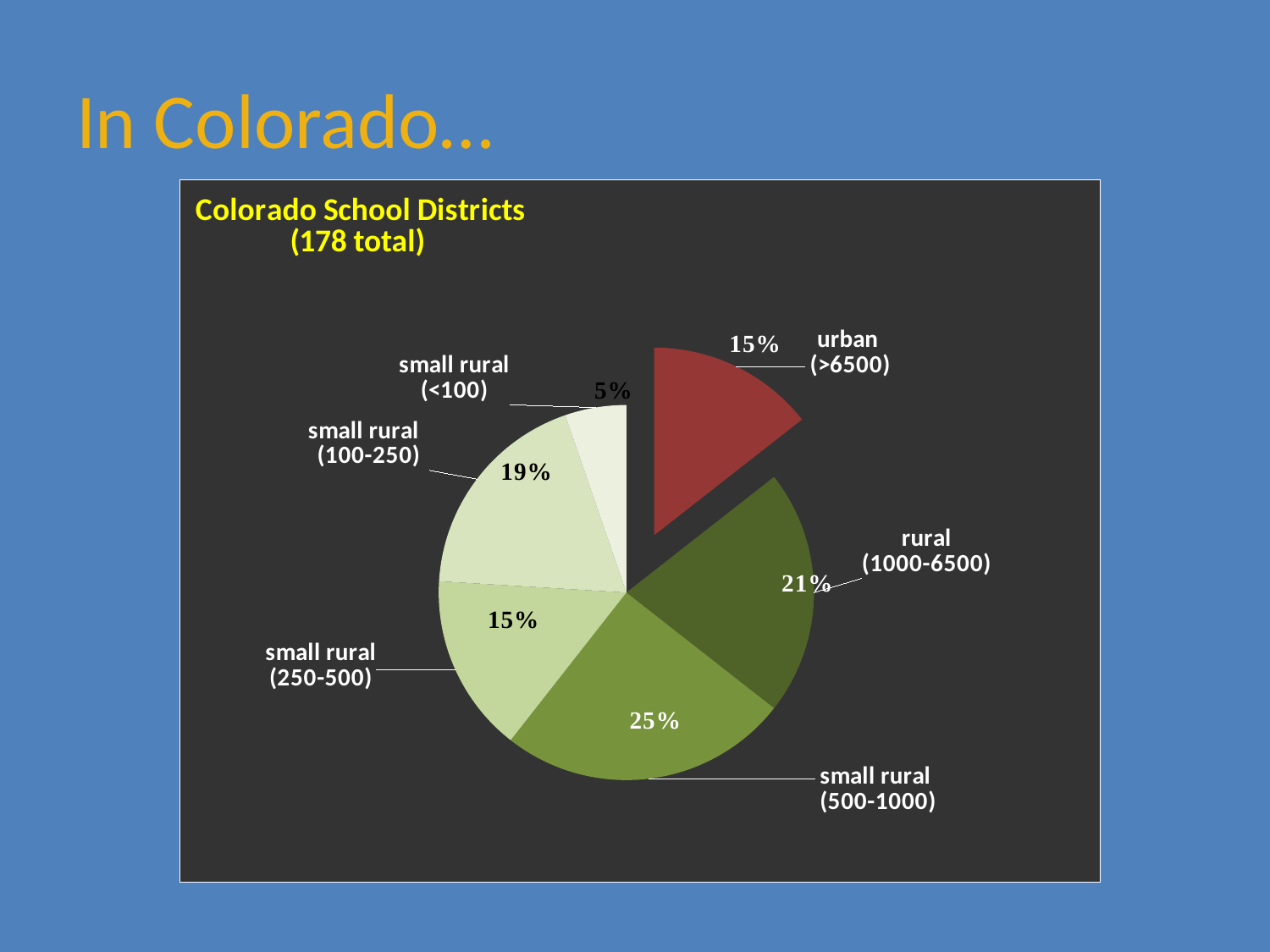
What share of the pie is the small rural (500-1000) slice? 25% Which is larger, the rural (1000-6500) share or the small rural (250-500) share? rural (1000-6500) What kind of chart is shown on the slide? pie chart How many slices does the pie chart have? 6 Which category has the smallest slice of the pie? small rural (<100) Which category has the largest slice of the pie? small rural (500-1000) What is the difference between the small rural (500-1000) share and the small rural (100-250) share? 6% What is the title of the chart? Colorado School Districts (178 total) What share of the pie is the small rural (<100) slice? 5% What share of the pie is the urban (>6500) slice? 15%